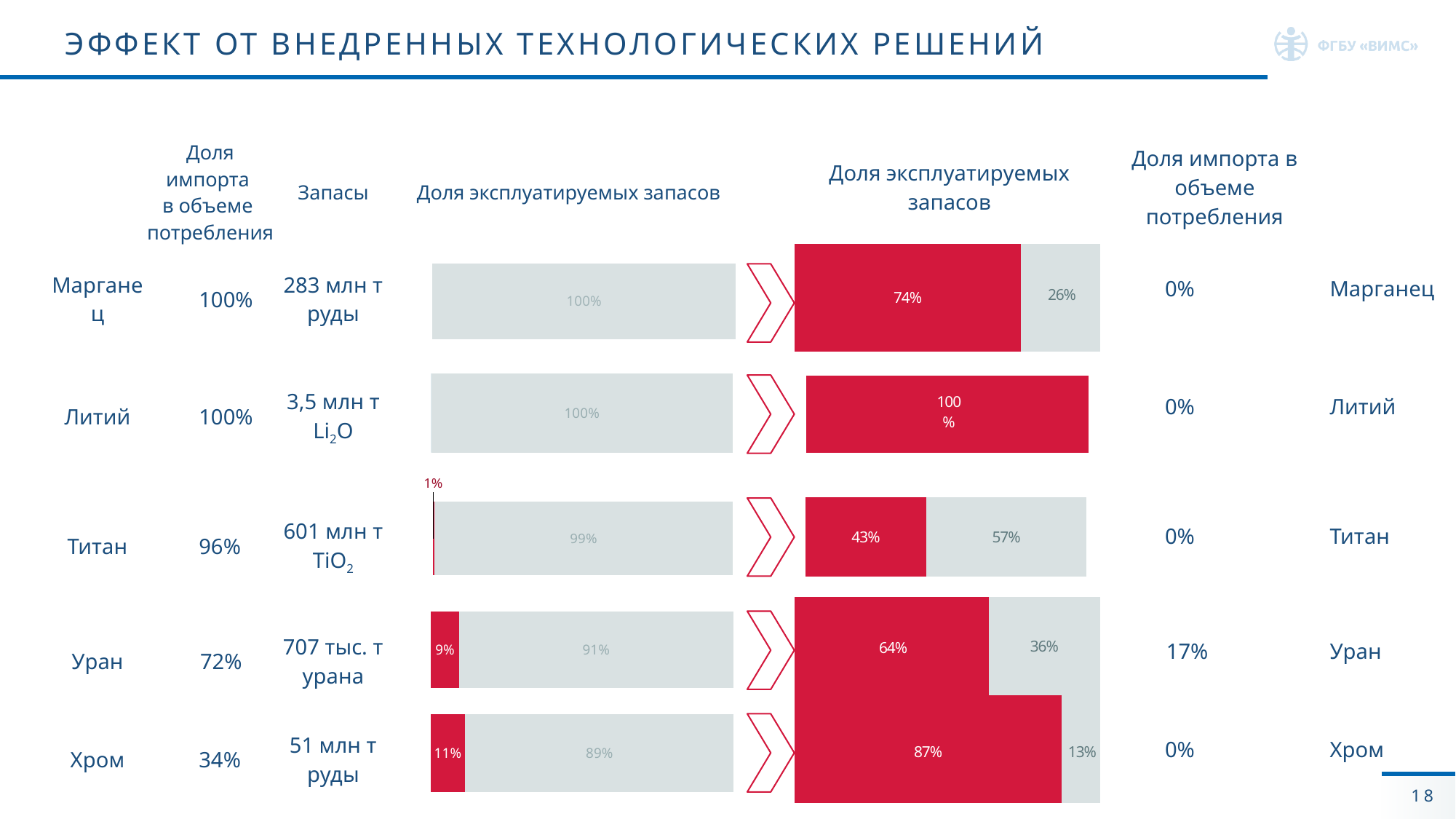
In the right-hand chart, what is the total of the red and grey shares for Уран? 100% In the left-hand chart (Доля эксплуатируемых запасов, before), what is the red share for Уран? 9% In the left-hand chart, what is the red share for Титан? 1% In the right-hand chart, what is the difference between the red share for Хром and the red share for Уран? 23% In the right-hand chart, is the red share for Уран larger than the red share for Титан? Yes, Уран In the right-hand chart, which category has the lowest red share? Титан What type of chart is used to show Доля эксплуатируемых запасов? Stacked bar chart In the right-hand chart (Доля эксплуатируемых запасов, after), what is the red share for Марганец? 74% In the left-hand chart, what is the red share for Хром? 11% How many categories (rows) are shown in the left-hand chart? 5 In the right-hand chart, which category has the highest red share? Литий In the right-hand chart, what is the grey share for Титан? 57%